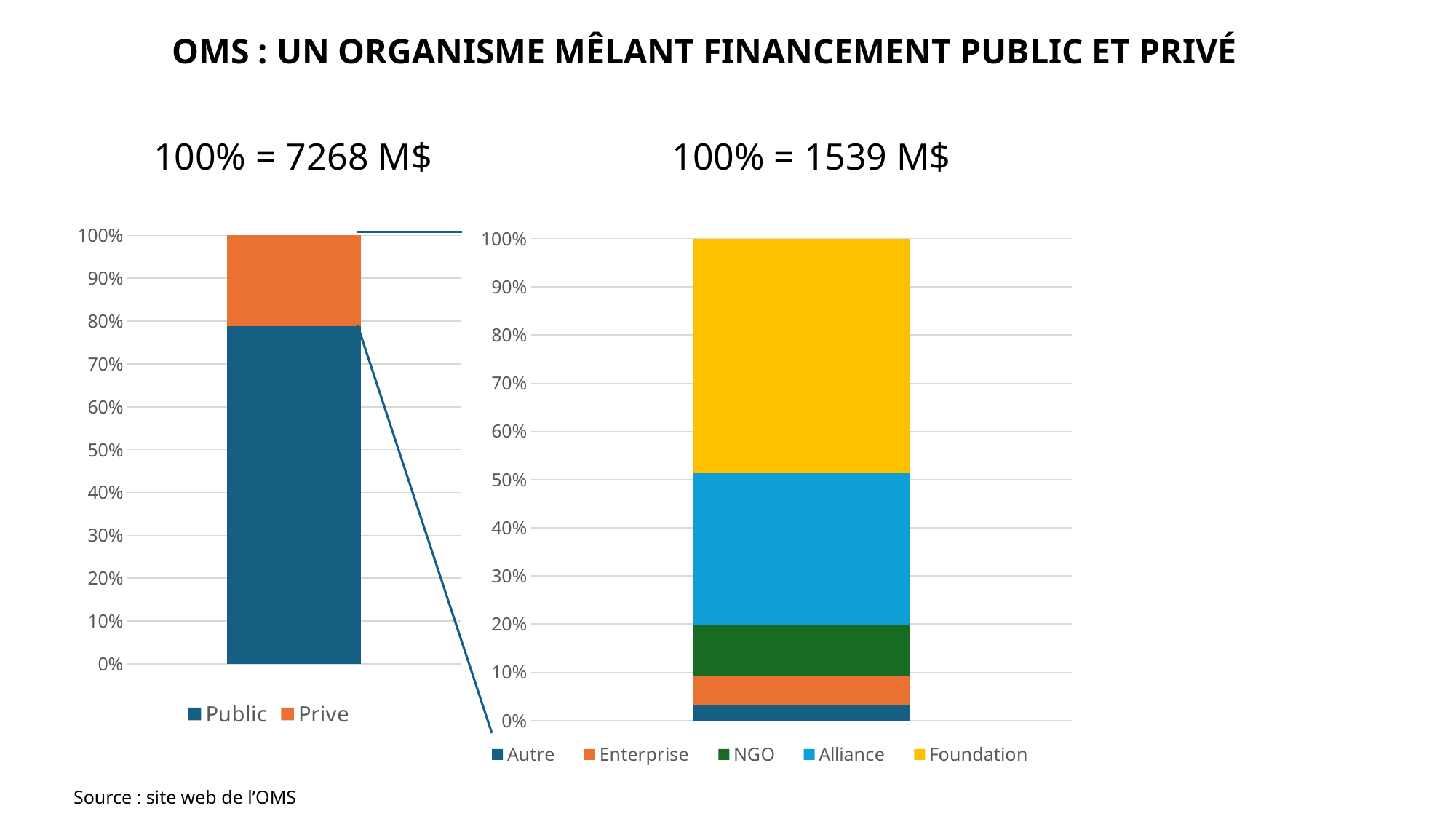
What total amount does 100% represent in the right chart? 1539 M$ How many series does the legend of the right chart (100% = 1539 M$) list? 5 In the right chart (100% = 1539 M$), which is larger, Alliance or NGO? Alliance In the left chart (100% = 7268 M$), which is larger, Public or Prive? Public In the right chart (100% = 1539 M$), which series has the largest share? Foundation In the right chart (100% = 1539 M$), is the share for Alliance greater or less than 20%? greater In the right chart (100% = 1539 M$), is the share for Foundation greater or less than 60%? less In the left chart (100% = 7268 M$), is the share for Public greater or less than 70%? greater How many series does the legend of the left chart (100% = 7268 M$) list? 2 What kind of chart is the left chart (100% = 7268 M$)? stacked bar chart In the right chart (100% = 1539 M$), which series has the smallest share? Autre